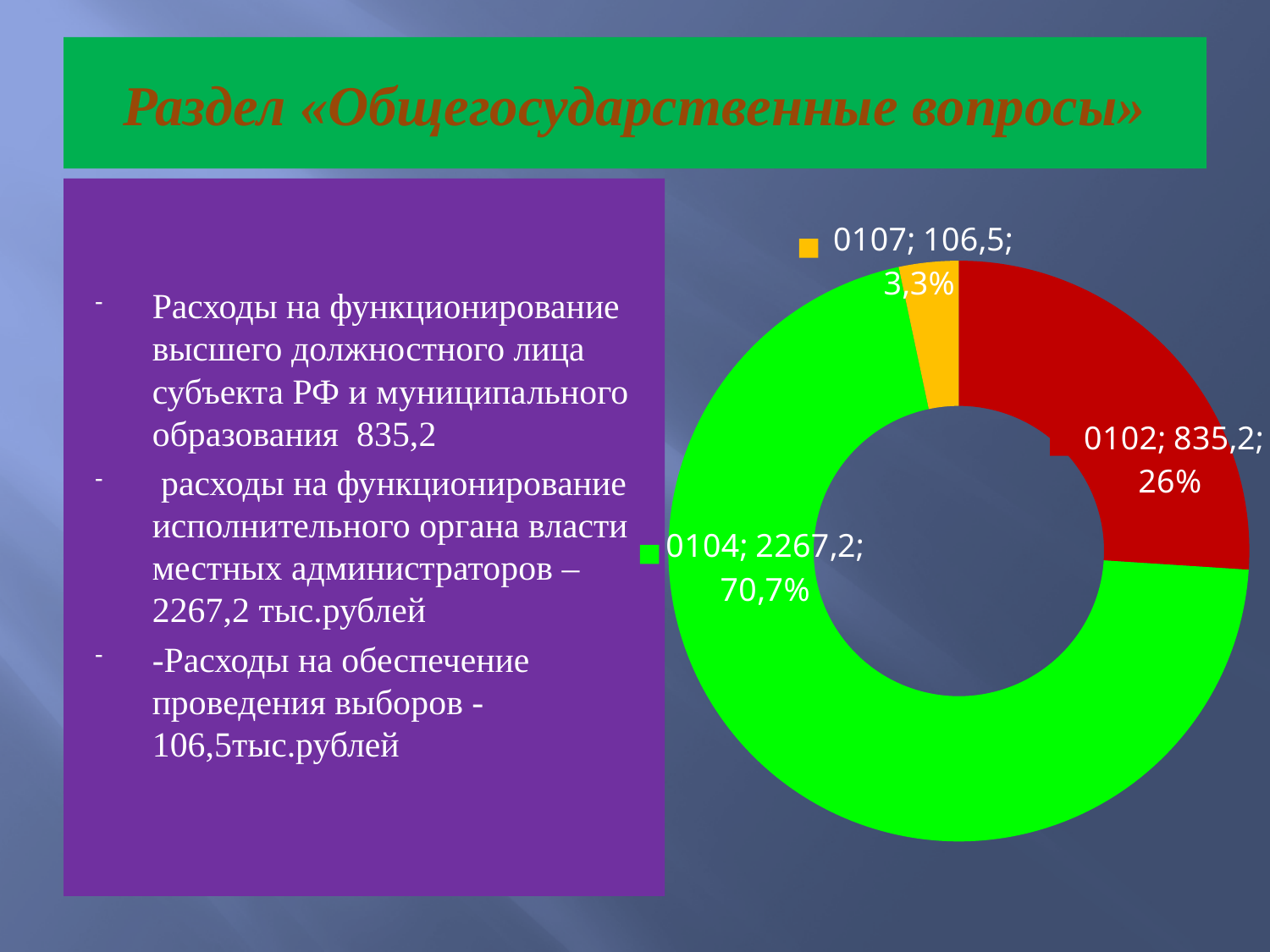
What is the value for category 0102? 835,2 What is the value for category 0107? 106,5 What share of the chart does category 0107 represent? 3,3% Which category has the smallest slice? 0107 Which category has the largest slice? 0104 How many slices does the chart have? 3 What colour is the slice for category 0104? green What kind of chart is shown on the slide? doughnut chart What is the value for category 0104? 2267,2 What is the difference between the values for 0104 and 0102? 1432,0 Which is larger, the value for 0102 or the value for 0107? 0102 What share of the chart does category 0102 represent? 26%